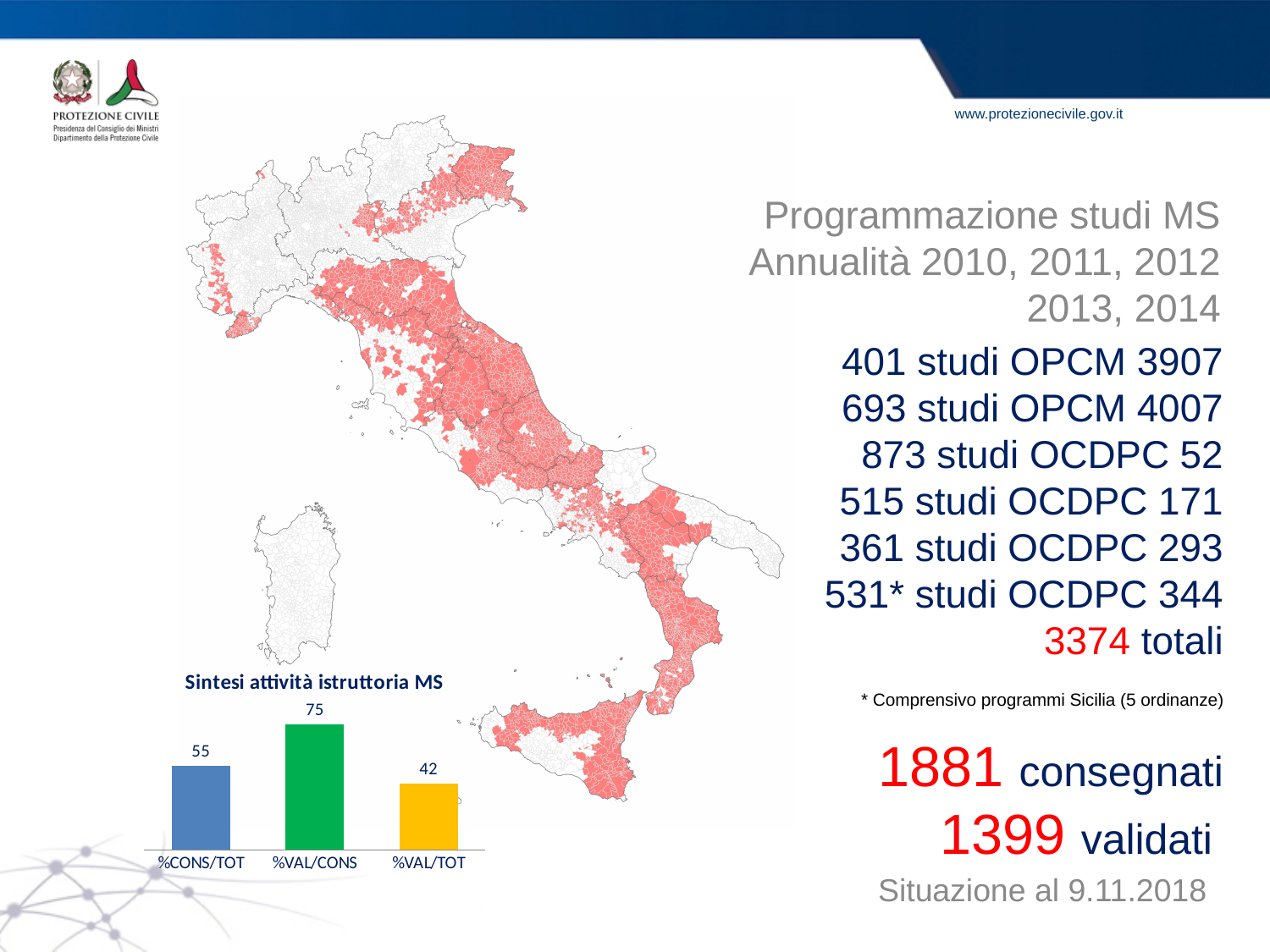
What is the value for %VAL/CONS in the 'Sintesi attività istruttoria MS' chart? 75 How many bars are shown in the 'Sintesi attività istruttoria MS' chart? 3 What is the title of the chart on the slide? Sintesi attività istruttoria MS What is the value for %VAL/TOT in the 'Sintesi attività istruttoria MS' chart? 42 What is the difference between the %CONS/TOT and %VAL/TOT values in the 'Sintesi attività istruttoria MS' chart? 13 What is the value for %CONS/TOT in the 'Sintesi attività istruttoria MS' chart? 55 What is the difference between the %VAL/CONS and %CONS/TOT values in the 'Sintesi attività istruttoria MS' chart? 20 Which category has the lowest value in the 'Sintesi attività istruttoria MS' chart? %VAL/TOT Which category has the highest value in the 'Sintesi attività istruttoria MS' chart? %VAL/CONS What kind of chart is 'Sintesi attività istruttoria MS'? bar chart What colour is the %VAL/CONS bar in the 'Sintesi attività istruttoria MS' chart? green In the 'Sintesi attività istruttoria MS' chart, which is larger: %CONS/TOT or %VAL/TOT? %CONS/TOT